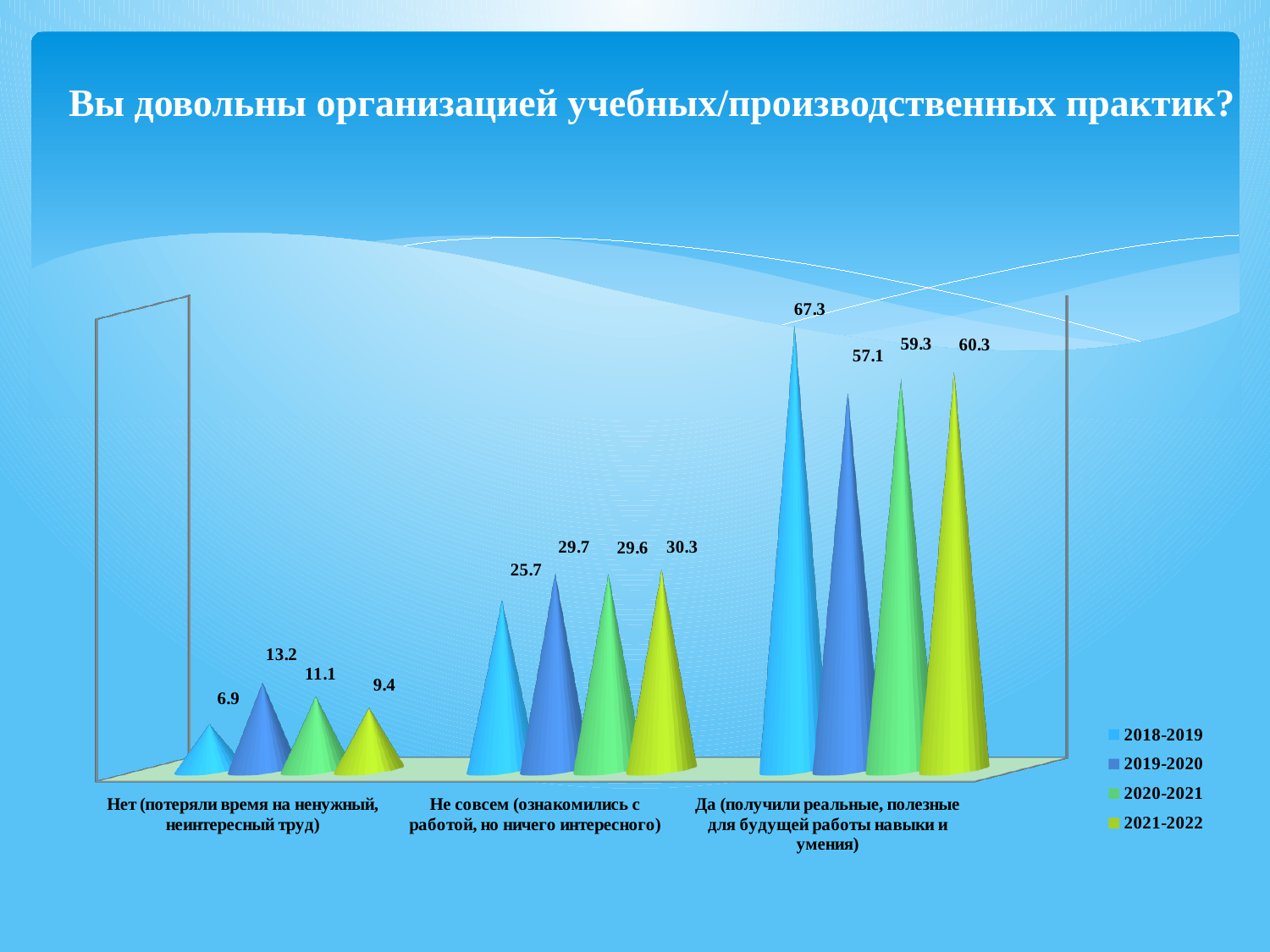
What kind of chart is shown on the slide? Bar chart Which year has the lowest value in the category "Да (получили реальные, полезные для будущей работы навыки и умения)"? 2019-2020 What is the value for 2019-2020 in the category "Не совсем (ознакомились с работой, но ничего интересного)"? 29.7 How many series does the legend list? 4 Which series is shown in yellow-green in the legend? 2021-2022 How many categories are shown on the x axis? 3 What is the difference between the 2018-2019 and 2019-2020 values in the category "Да (получили реальные, полезные для будущей работы навыки и умения)"? 10.2 What is the value for 2018-2019 in the category "Да (получили реальные, полезные для будущей работы навыки и умения)"? 67.3 Which is larger: the 2020-2021 value or the 2021-2022 value in the category "Да (получили реальные, полезные для будущей работы навыки и умения)"? 2021-2022 What is the difference between the 2019-2020 and 2018-2019 values in the category "Нет (потеряли время на ненужный, неинтересный труд)"? 6.3 Which year has the highest value in the category "Нет (потеряли время на ненужный, неинтересный труд)"? 2019-2020 What is the value for 2021-2022 in the category "Нет (потеряли время на ненужный, неинтересный труд)"? 9.4